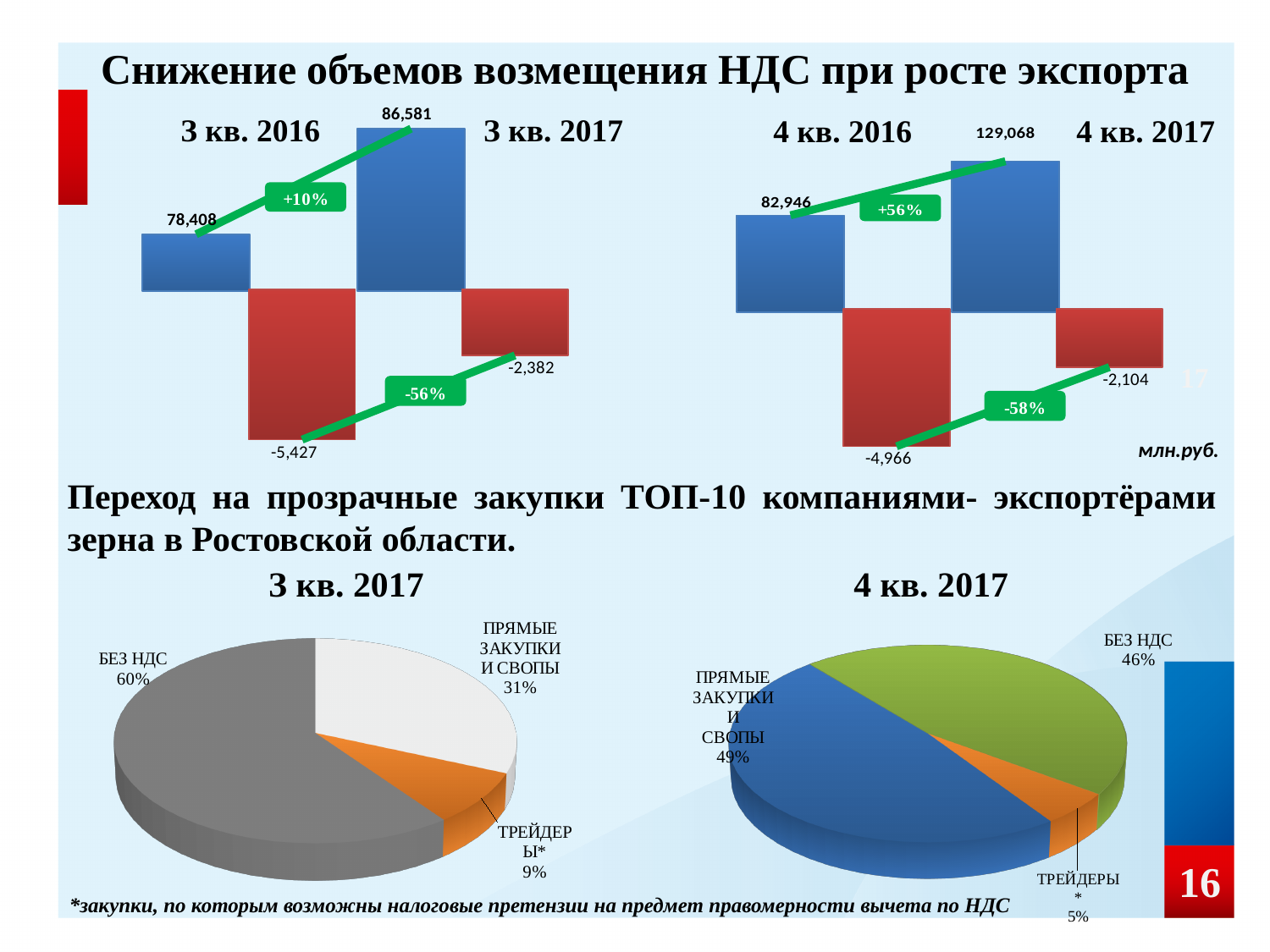
How many slices does the pie chart titled 4 кв. 2017 have? 3 In the top-left bar chart (3 кв. 2016 / 3 кв. 2017), what is the value of the blue bar for 3 кв. 2016? 78,408 In the top-left bar chart (3 кв. 2016 / 3 кв. 2017), what is the value of the red bar for 3 кв. 2016? -5,427 In the pie chart titled 3 кв. 2017, what share is labelled БЕЗ НДС? 60% In the top-left bar chart (3 кв. 2016 / 3 кв. 2017), what is the value of the blue bar for 3 кв. 2017? 86,581 In the top-right bar chart (4 кв. 2016 / 4 кв. 2017), what is the value of the red bar for 4 кв. 2017? -2,104 In the top-right bar chart (4 кв. 2016 / 4 кв. 2017), what is the value of the blue bar for 4 кв. 2017? 129,068 In the top-right bar chart (4 кв. 2016 / 4 кв. 2017), which blue bar is larger, 4 кв. 2016 or 4 кв. 2017? 4 кв. 2017 In the pie chart titled 3 кв. 2017, which slice is the smallest? ТРЕЙДЕРЫ* In the top-left bar chart (3 кв. 2016 / 3 кв. 2017), what percentage change is shown between the two red bars? -56% In the top-right bar chart (4 кв. 2016 / 4 кв. 2017), what is the difference between the blue bars for 4 кв. 2017 and 4 кв. 2016? 46,122 In the pie chart titled 4 кв. 2017, what share is labelled ПРЯМЫЕ ЗАКУПКИ И СВОПЫ? 49%